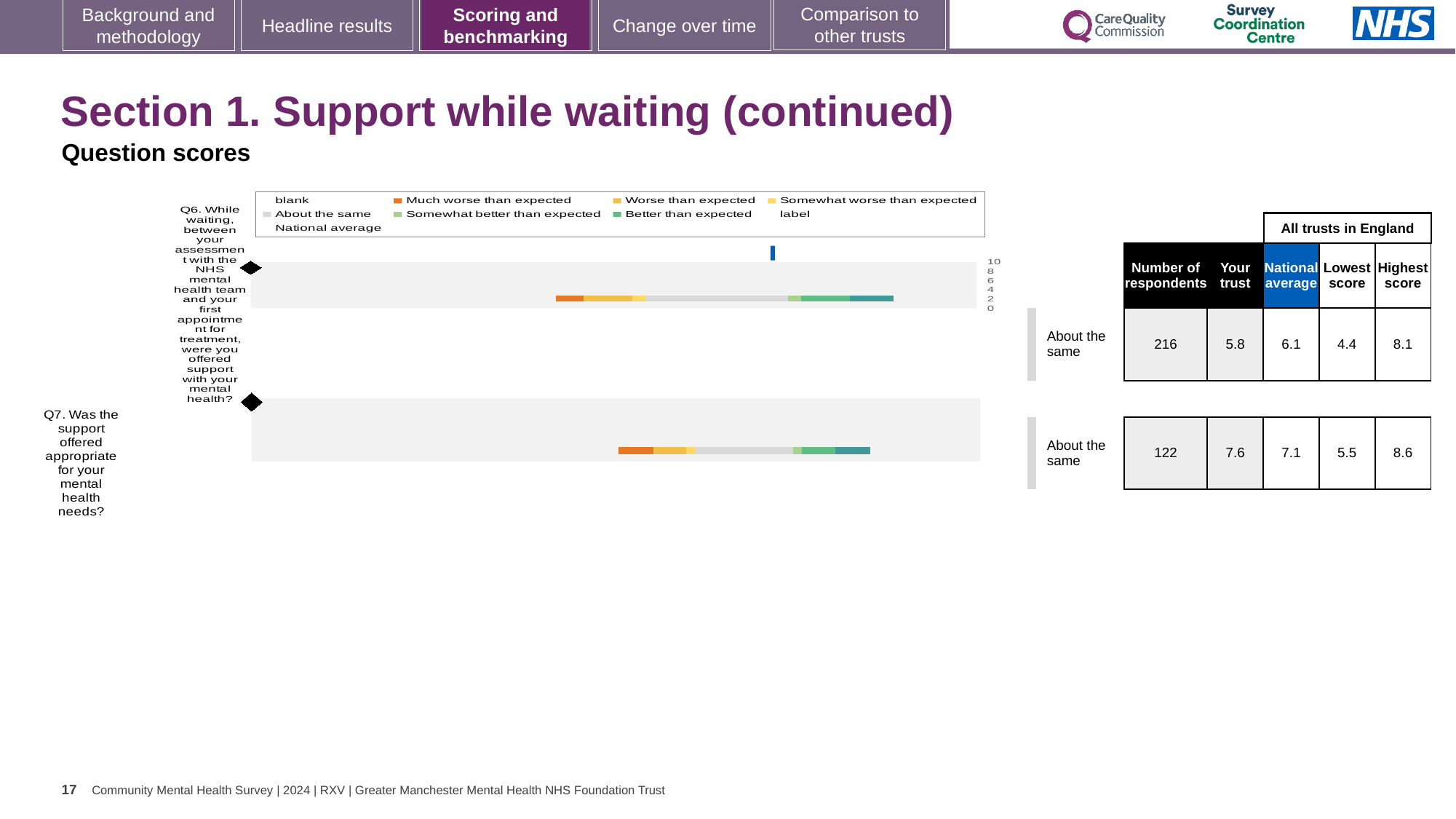
What is the difference between the trust's score and the national average for Q7? 0.5 What is the 'Your trust' score for Q6 (support while waiting between assessment and first appointment)? 5.8 What is the difference between the highest and lowest scores for Q6 across all trusts in England? 3.7 What is the lowest score among all trusts in England for Q6? 4.4 What is the national average score for Q7 (was the support offered appropriate for your mental health needs)? 7.1 How many respondents answered Q7? 122 What is the highest score among all trusts in England for Q7? 8.6 How many respondents answered Q6? 216 How is the trust's result for Q6 categorised relative to other trusts? About the same What type of chart is used to show the question scores? Bar chart Which question has the higher 'Your trust' score, Q6 or Q7? Q7 How many questions are plotted on the chart? 2